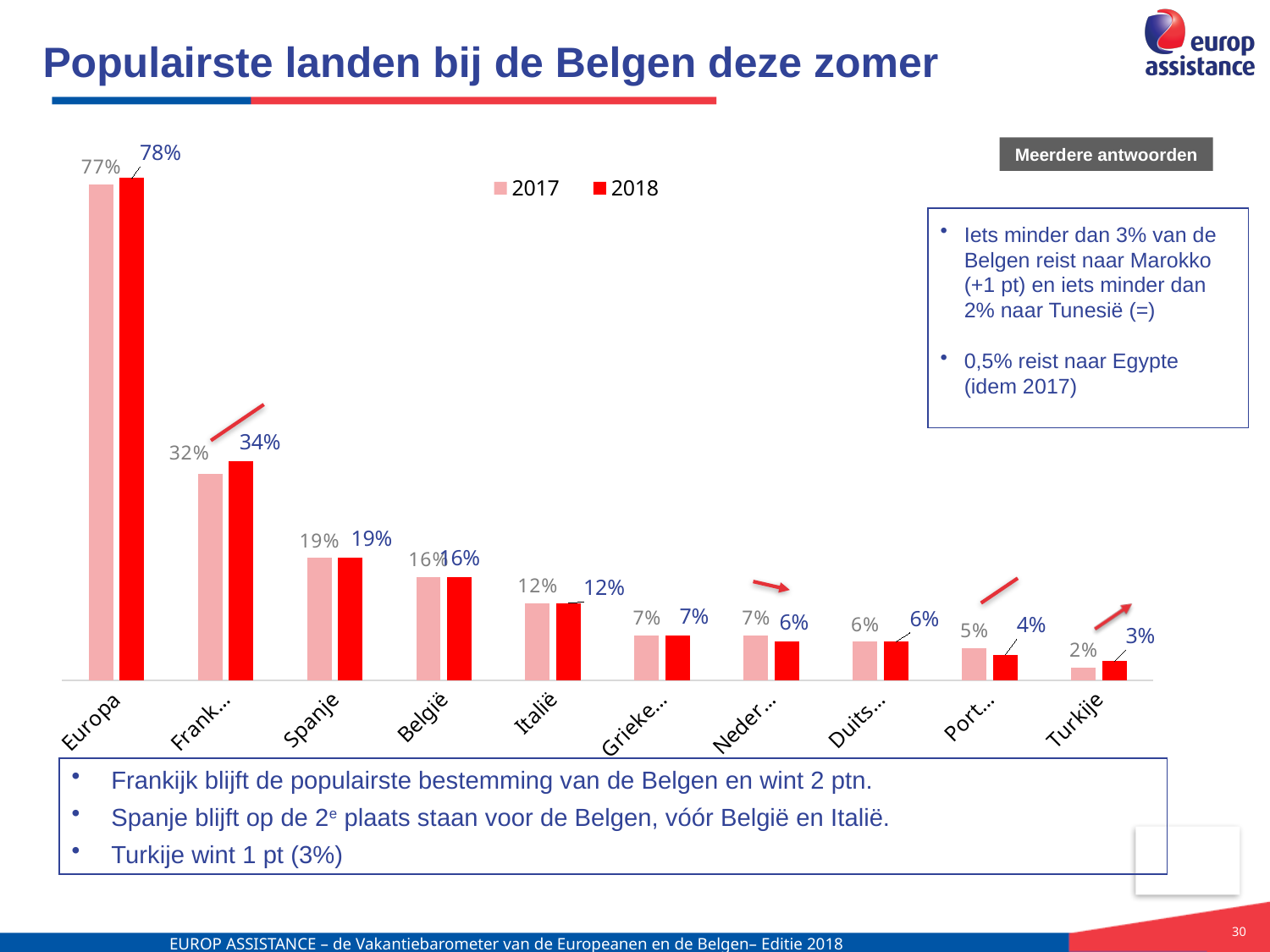
What is the difference between the 2018 and 2017 values for Europa? 1 percentage point Which is larger for Turkije: the 2017 value or the 2018 value? 2018 What is the 2018 value for Turkije? 3% What is the 2018 value for België? 16% Which category has the highest 2018 value? Europa What is the 2018 value for Europa? 78% What is the 2017 value for Spanje? 19% How many series does the legend list? 2 Which category has the lowest 2017 value? Turkije How many categories are shown on the x axis? 10 What kind of chart is shown on the slide? Bar chart What is the 2017 value for Italië? 12%